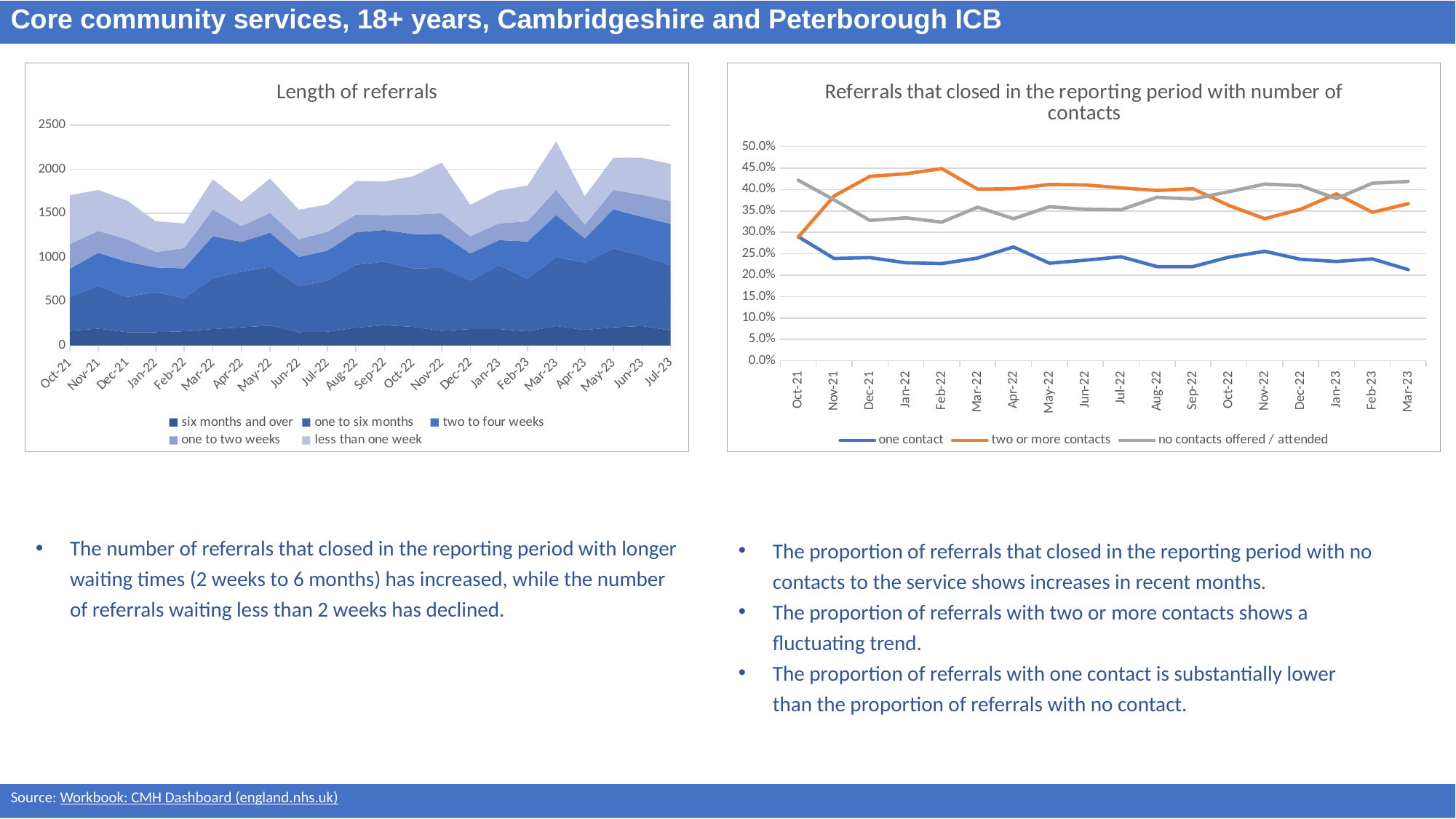
How many series does the legend of the 'Length of referrals' chart list? 5 How many series does the legend of the 'Referrals that closed in the reporting period with number of contacts' chart list? 3 In the 'Length of referrals' chart, is the total stacked value for Mar-23 greater or less than 2000? greater In the right-hand chart, is the value for 'one contact' in Oct-21 greater or less than 25.0%? greater How many months are shown on the x axis of the 'Length of referrals' chart? 22 In the 'Length of referrals' chart, is the total stacked value for Jan-22 greater or less than 1500? less What kind of chart is the 'Referrals that closed in the reporting period with number of contacts' chart on the right? line chart What kind of chart is the 'Length of referrals' chart on the left? stacked area chart In the right-hand chart, does the 'one contact' line rise or fall from Nov-22 to Mar-23? fall How many months are shown on the x axis of the 'Referrals that closed in the reporting period with number of contacts' chart? 18 In the right-hand chart, which is larger in Mar-23: 'one contact' or 'no contacts offered / attended'? no contacts offered / attended